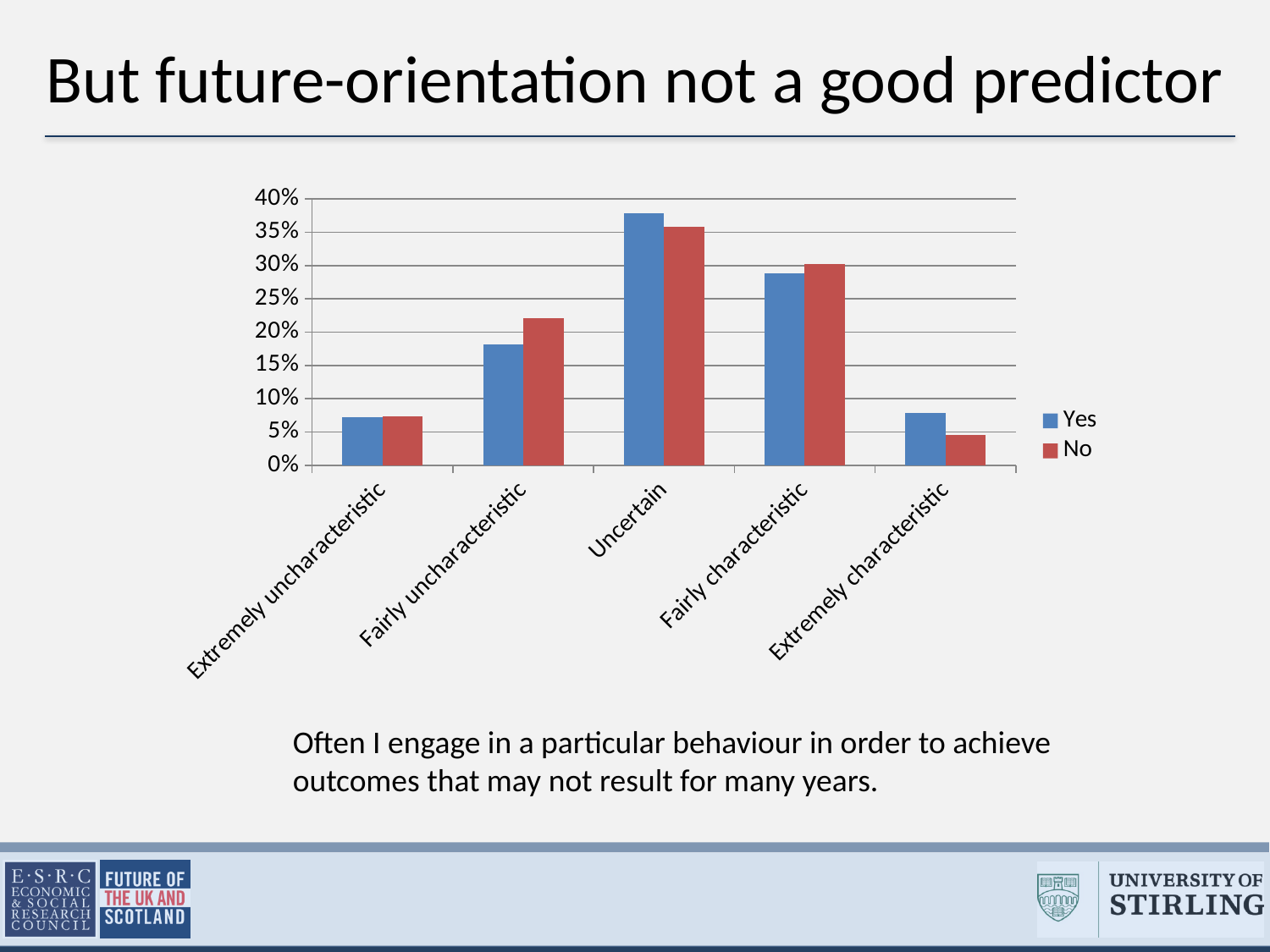
What colour are the bars for the No series? red Which category has the highest value for the Yes series? Uncertain Is the No value for Fairly uncharacteristic greater or less than 20%? greater What kind of chart is shown on the slide? bar chart Is the No value for Extremely characteristic greater or less than 5%? less For Extremely characteristic, which series has the larger value, Yes or No? Yes Is the Yes value for Uncertain greater or less than 35%? greater Which category has the highest value for the No series? Uncertain For Fairly uncharacteristic, which series has the larger value, Yes or No? No How many categories are shown on the x axis? 5 Which category has the lowest value for the No series? Extremely characteristic How many series does the legend list? 2